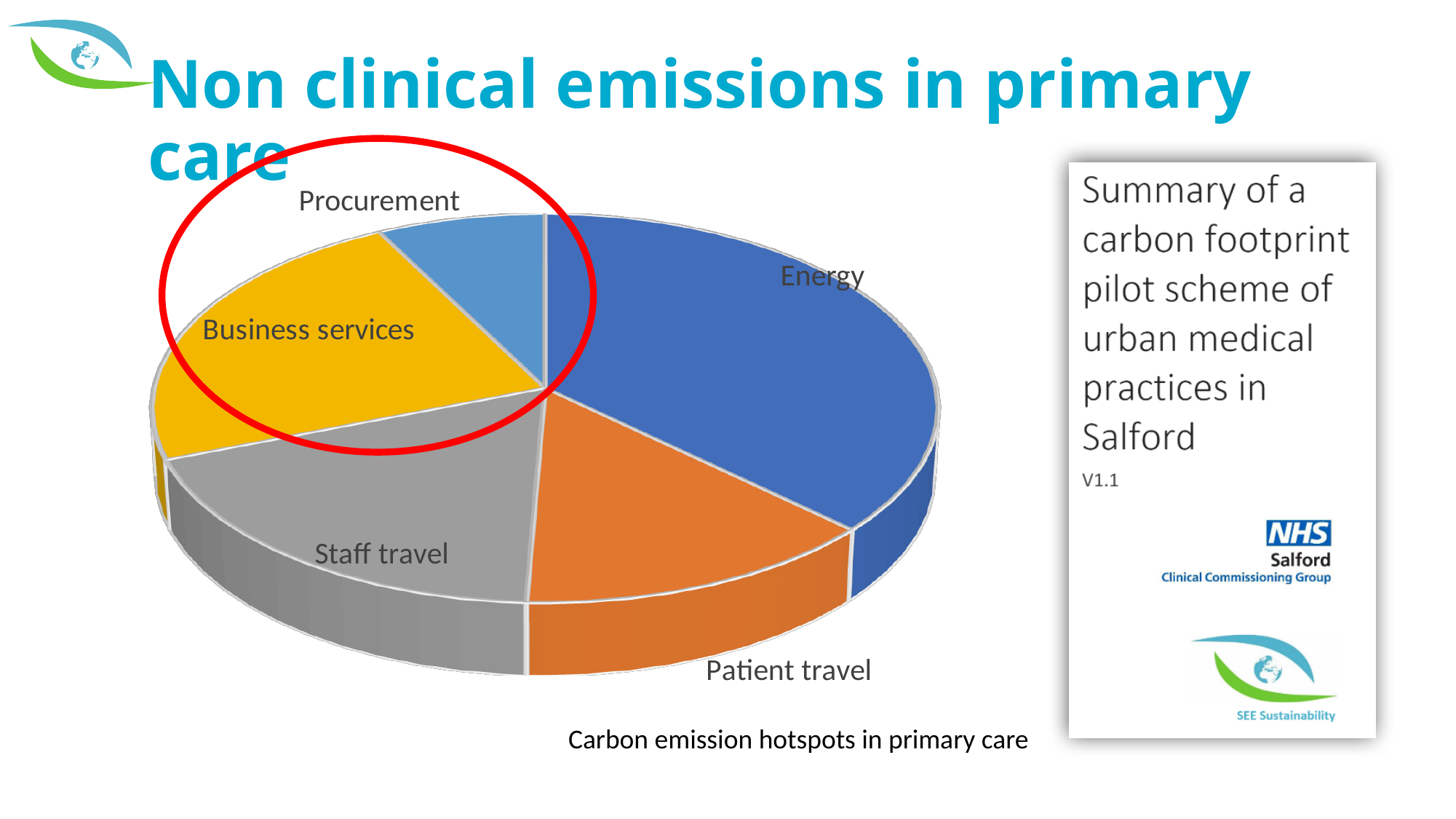
What caption appears below the pie chart? Carbon emission hotspots in primary care Which slice is larger, Business services or Procurement? Business services What colour is the Staff travel slice? Grey Which category has the smallest slice of the pie chart? Procurement Which slice is larger, Energy or Business services? Energy Which slice is larger, Energy or Patient travel? Energy What kind of chart is shown on the slide? Pie chart How many slices does the pie chart have? 5 Which category has the largest slice of the pie chart? Energy